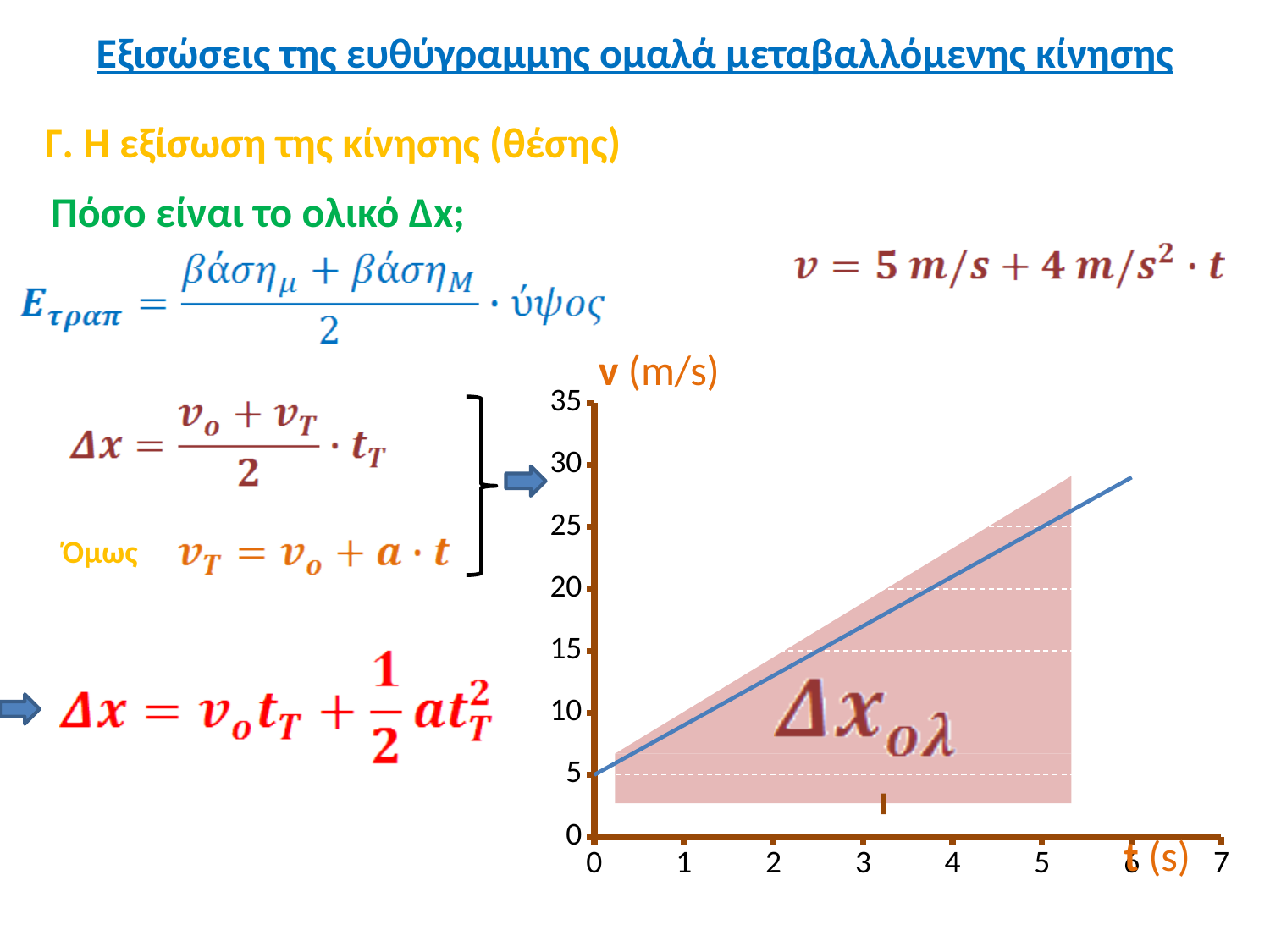
Is the value of v at t = 1 greater or less than 10? less What is the highest tick value shown on the vertical axis? 35 What is the label of the horizontal axis of the chart? t (s) What is the value of v at t = 0 on the chart? 5 Is the value of v at t = 5 greater or less than 20? greater Does the velocity v rise or fall as t increases along the x axis? rise Is the value of v at t = 2 greater or less than 15? less What is the label of the vertical axis of the chart? v (m/s) What kind of chart is shown on the slide? line chart What is the highest tick value shown on the horizontal axis? 7